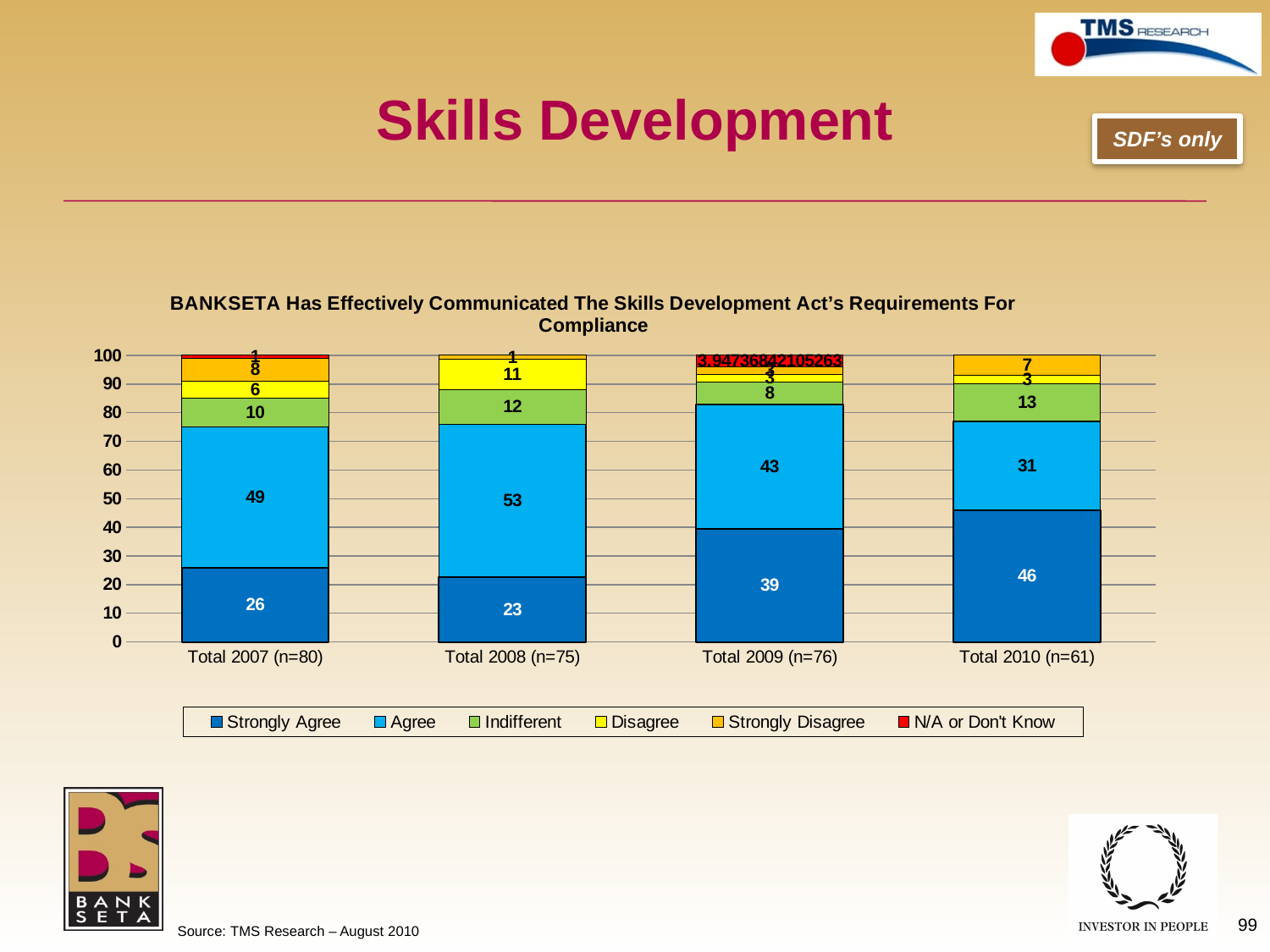
What is the title of the chart? BANKSETA Has Effectively Communicated The Skills Development Act's Requirements For Compliance What is the Agree value for Total 2008 (n=75)? 53 Which is larger: the Agree value for Total 2007 or for Total 2009? Total 2007 Which year has the highest Strongly Agree value? Total 2010 (n=61) What is the Strongly Agree value for Total 2010 (n=61)? 46 How many bars (survey years) are shown on the chart? 4 From Total 2008 to Total 2010, does the Agree value rise or fall? Fall Which year has the lowest Agree value? Total 2010 (n=61) How many series does the legend list? 6 What is the Indifferent value for Total 2007 (n=80)? 10 What is the difference between the Strongly Agree values for Total 2010 and Total 2009? 7 What type of chart is shown on the slide? Stacked bar chart